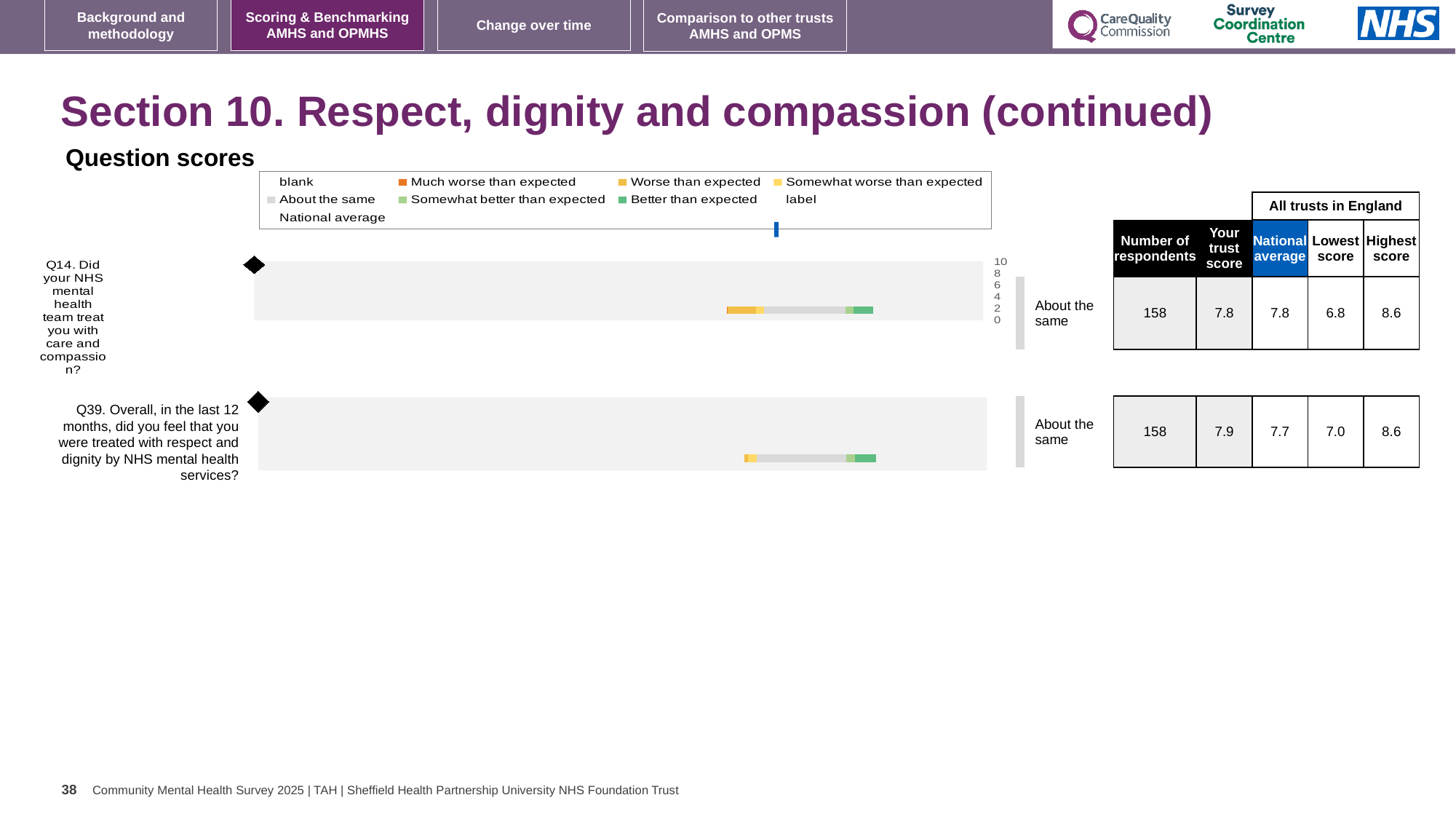
What is the difference between the highest and lowest scores for Q39? 1.6 What is the highest score among all trusts in England for Q14? 8.6 Which question has the higher trust score, Q14 or Q39? Q39 What is the national average for Q39 (treated with respect and dignity)? 7.7 How many questions are plotted in the question scores chart? 2 What kind of chart is used to show the question scores on this slide? bar chart What benchmark category is shown next to the bar for Q14? About the same What is the maximum value shown on the chart's score axis? 10 What is the lowest score among all trusts in England for Q39? 7.0 By how much does the trust score for Q39 exceed the national average for Q39? 0.2 What is the trust score for Q14 (care and compassion)? 7.8 What is the number of respondents for Q14? 158